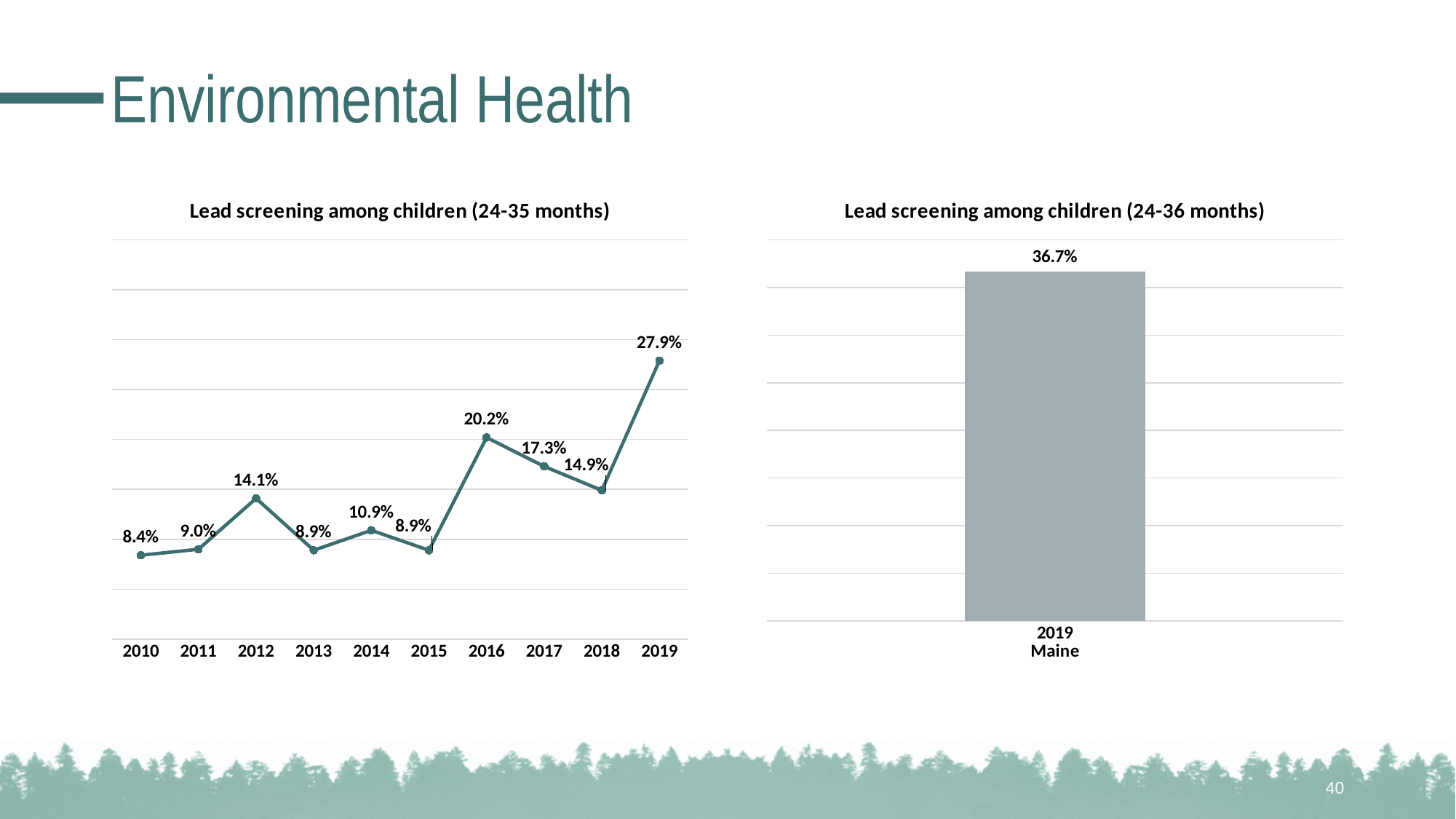
In the 'Lead screening among children (24-36 months)' chart, what is the value for Maine in 2019? 36.7% What kind of chart is the 'Lead screening among children (24-36 months)' chart? Bar chart In the 'Lead screening among children (24-35 months)' chart, which year has the lowest value? 2010 How many years are plotted in the 'Lead screening among children (24-35 months)' chart? 10 In the 'Lead screening among children (24-35 months)' chart, what is the value for 2016? 20.2% In the 'Lead screening among children (24-35 months)' chart, does the value rise or fall from 2016 to 2018? Fall In the 'Lead screening among children (24-35 months)' chart, which is larger, the value for 2012 or the value for 2014? 2012 In the 'Lead screening among children (24-35 months)' chart, which year has the highest value? 2019 In the 'Lead screening among children (24-35 months)' chart, what is the difference between the 2019 value and the 2018 value? 13.0% How many bars are shown in the 'Lead screening among children (24-36 months)' chart? 1 In the 'Lead screening among children (24-35 months)' chart, what is the value for 2010? 8.4% What kind of chart is the 'Lead screening among children (24-35 months)' chart? Line chart